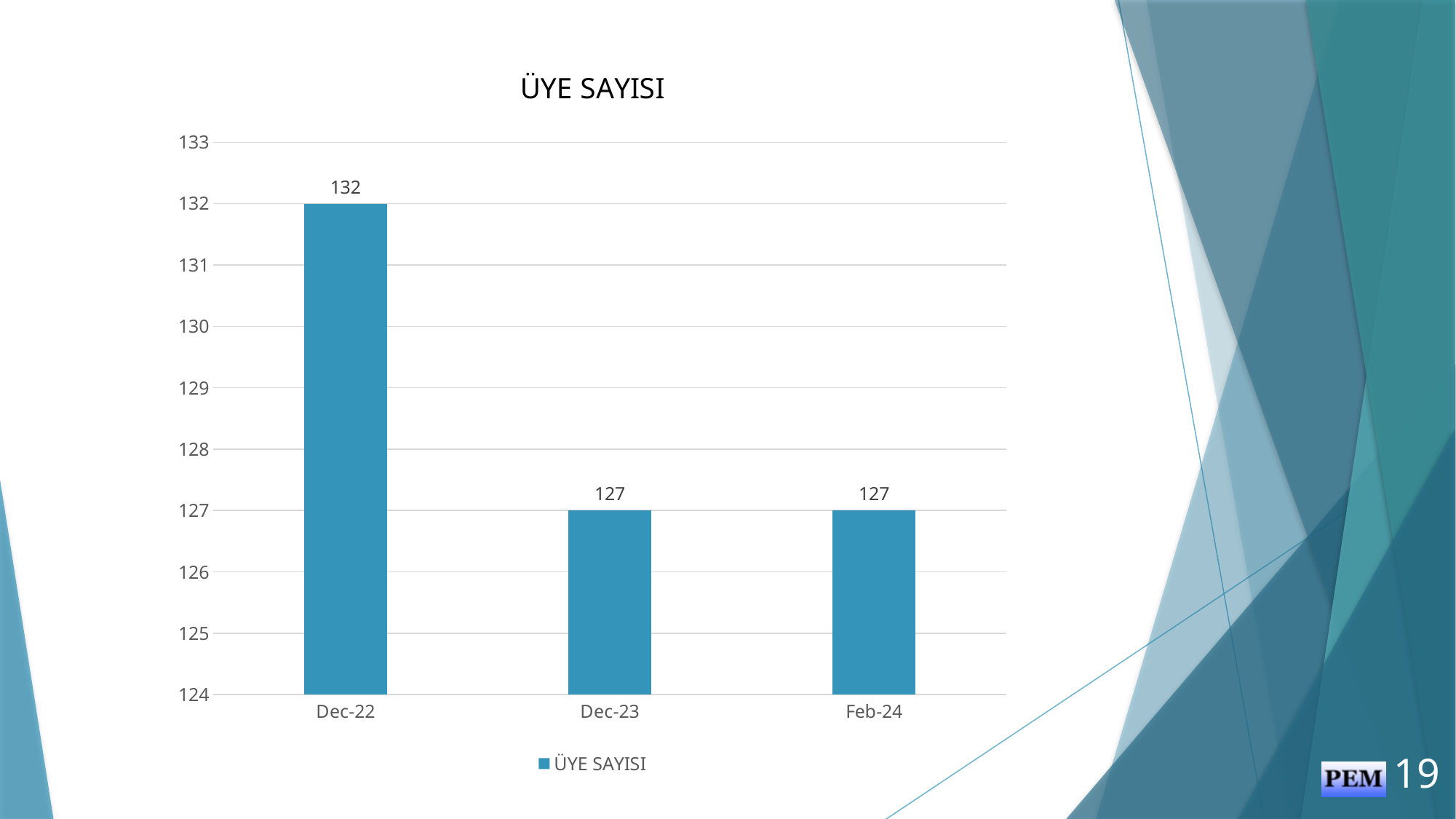
What is the value for Feb-24? 127 Is the value for Dec-22 greater or less than 130? greater What is the value for Dec-22? 132 Which category has the highest value? Dec-22 What is the value for Dec-23? 127 What is the difference between the values for Dec-22 and Dec-23? 5 How many series does the legend list? 1 What kind of chart is shown on the slide? bar chart How many categories are shown on the x axis? 3 Which is larger, the value for Dec-22 or the value for Feb-24? Dec-22 What is the title of the chart? ÜYE SAYISI Is the value for Feb-24 greater or less than 130? less